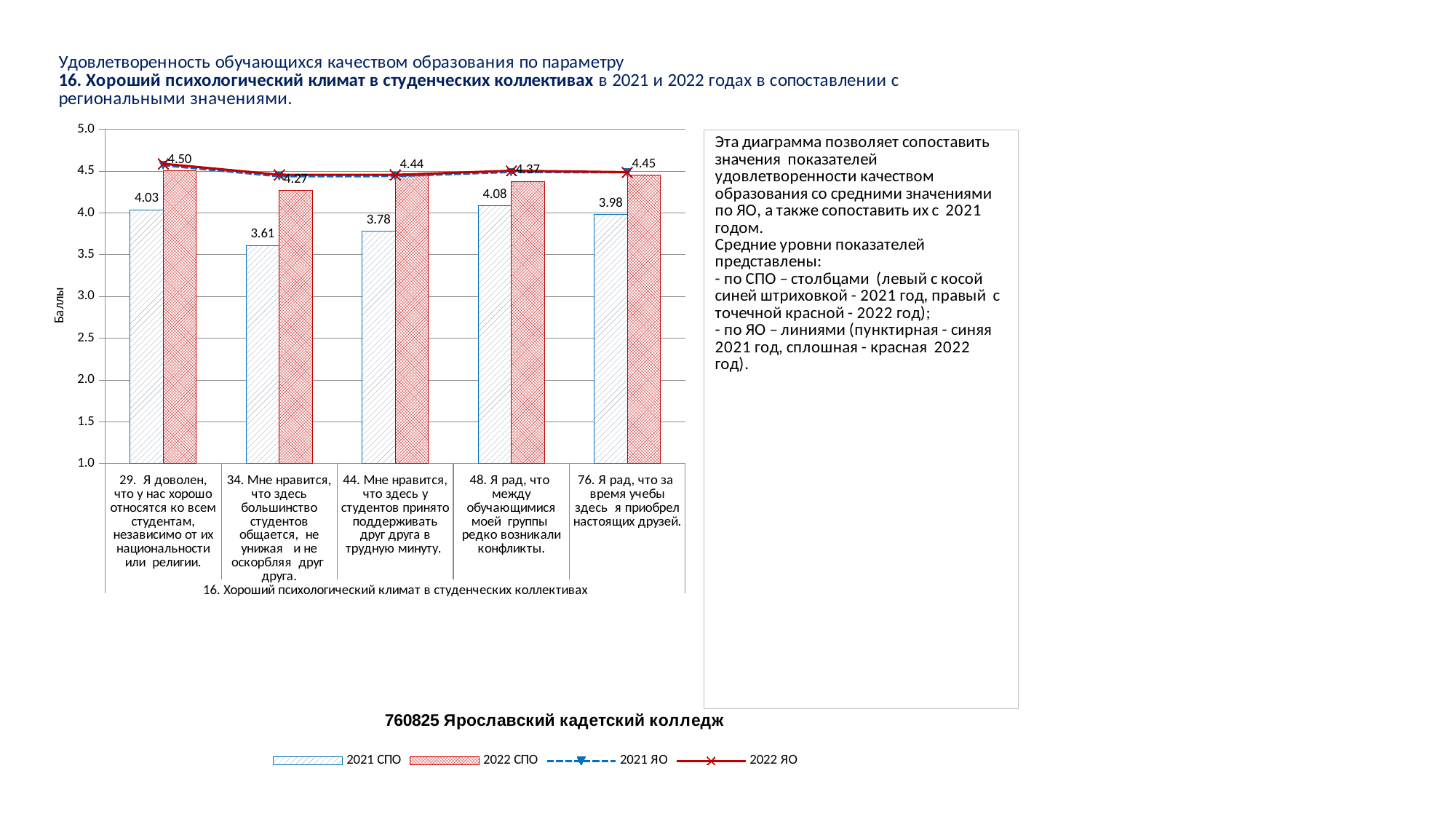
What is the 2022 СПО value for item 76 (Я рад, что за время учебы здесь я приобрел настоящих друзей)? 4.45 Which item has the lowest 2022 СПО value? 34. Мне нравится, что здесь большинство студентов общается, не унижая и не оскорбляя друг друга (4.27) What is the 2022 СПО value for item 34 (Мне нравится, что здесь большинство студентов общается, не унижая и не оскорбляя друг друга)? 4.27 How many series does the chart legend list? 4 How many items (categories) are shown on the x axis of the chart? 5 Which item has the highest 2022 СПО value? 29. Я доволен, что у нас хорошо относятся ко всем студентам, независимо от их национальности или религии (4.50) Which item has the lowest 2021 СПО value? 34. Мне нравится, что здесь большинство студентов общается, не унижая и не оскорбляя друг друга (3.61) What is the title of the vertical axis of the chart? Баллы What is the 2021 СПО value for item 29 (Я доволен, что у нас хорошо относятся ко всем студентам...)? 4.03 What is the difference between the 2022 СПО and 2021 СПО values for item 44 (Мне нравится, что здесь у студентов принято поддерживать друг друга в трудную минуту)? 0.66 Which is larger: the 2021 СПО value for item 48 or for item 76? Item 48 (4.08) Is the 2022 ЯО line value for item 29 greater or less than 4.0? greater